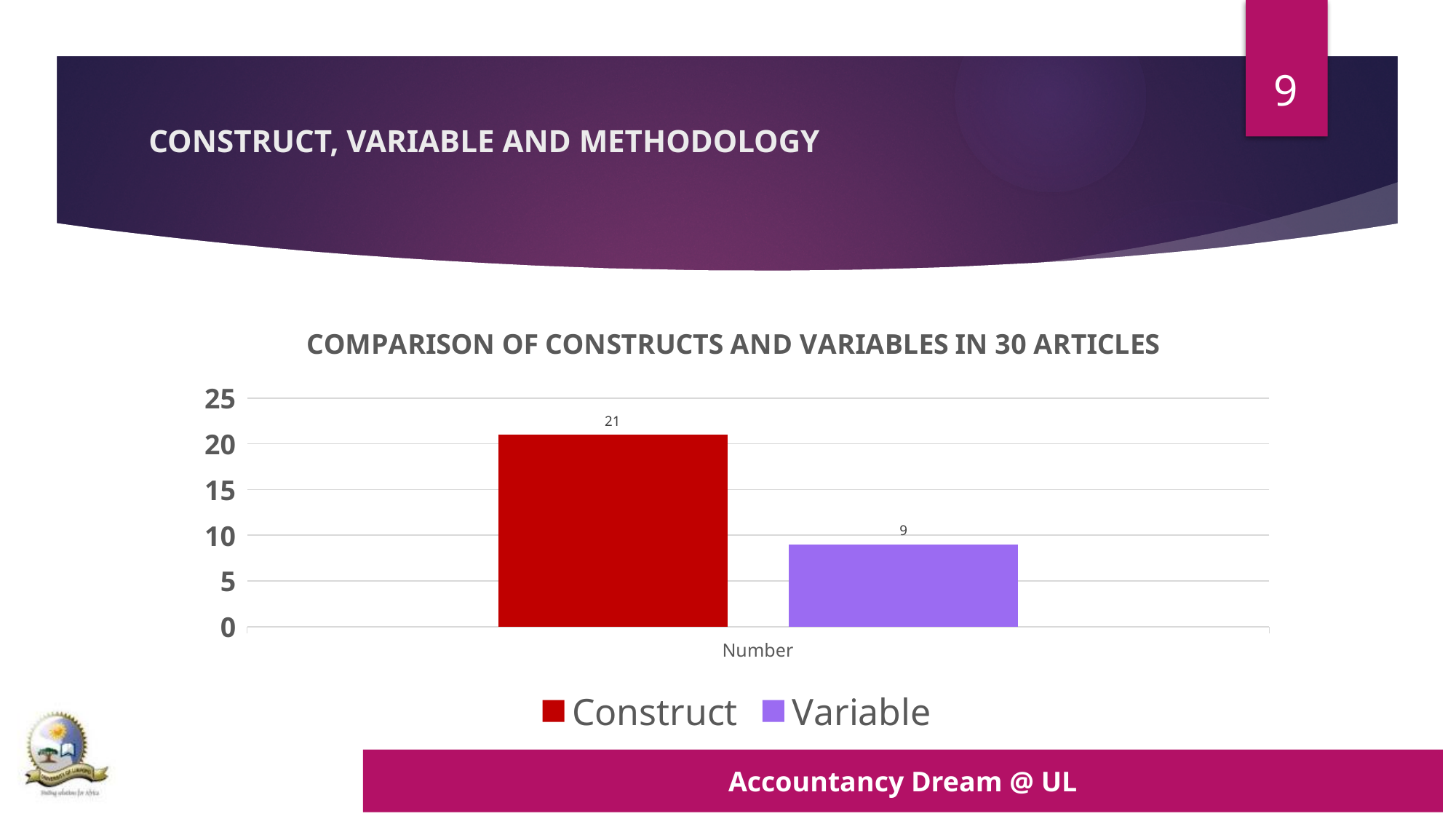
What is the highest value shown on the y axis? 25 What is the title of the chart? COMPARISON OF CONSTRUCTS AND VARIABLES IN 30 ARTICLES What is the value for Variable? 9 How many series does the legend list? 2 Is the value for Variable greater or less than 10? less What is the value for Construct? 21 Which series has the lowest value? Variable Is the value for Construct greater or less than 20? greater Which series has the higher value, Construct or Variable? Construct What is the difference between the Construct and Variable values? 12 What is the category label on the x axis? Number What kind of chart is shown on the slide? bar chart